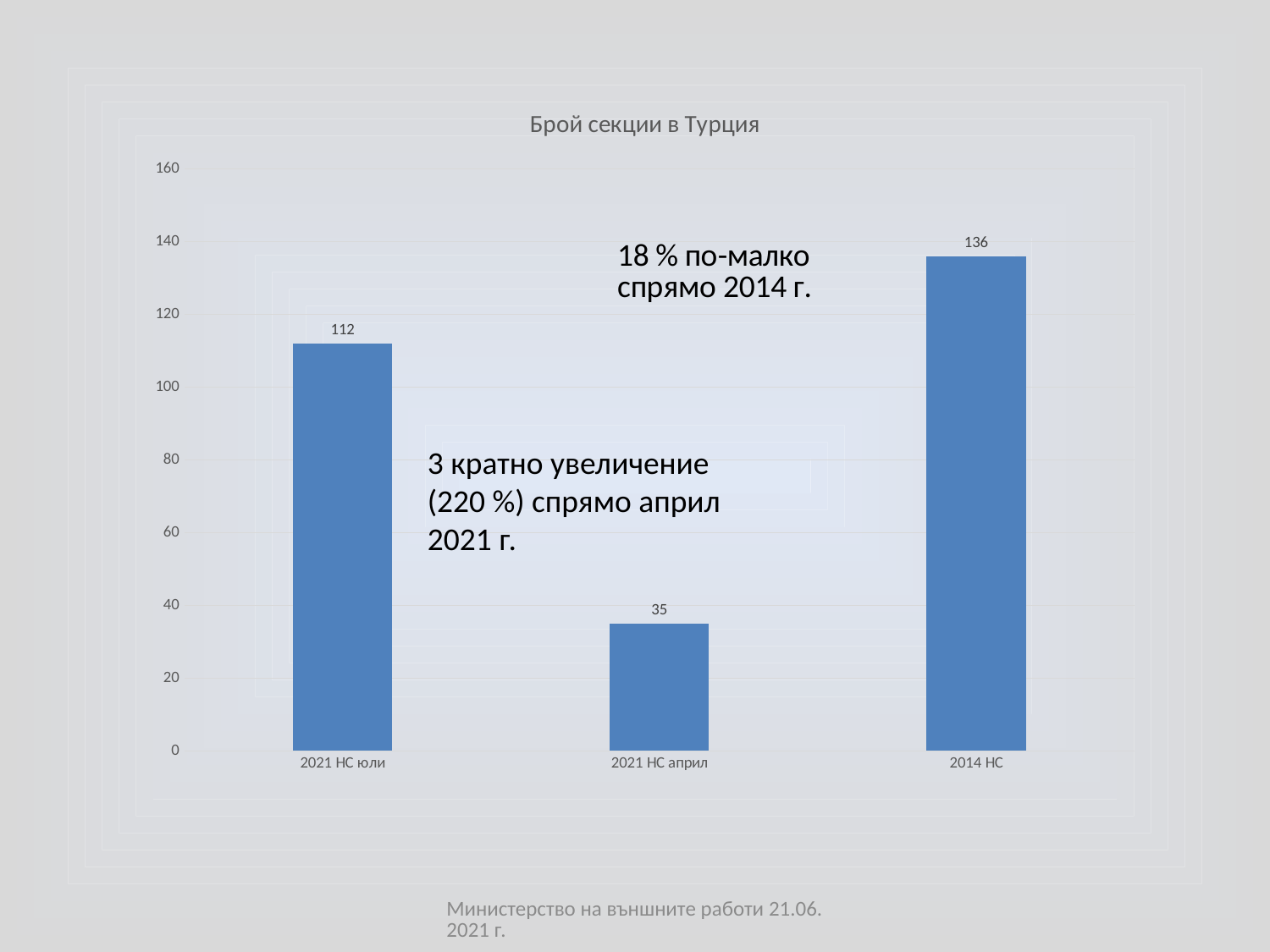
What is the difference between the values for 2014 НС and 2021 НС юли? 24 Is the value for 2021 НС април greater or less than 40? less How many categories are shown in the chart? 3 What is the title of the chart? Брой секции в Турция Which category has the highest value? 2014 НС What is the value for 2014 НС? 136 What kind of chart is shown on the slide? bar chart What is the difference between the values for 2021 НС юли and 2021 НС април? 77 What is the value for 2021 НС април? 35 What is the value for 2021 НС юли? 112 Which category has the lowest value? 2021 НС април Which is larger, the value for 2021 НС юли or the value for 2021 НС април? 2021 НС юли